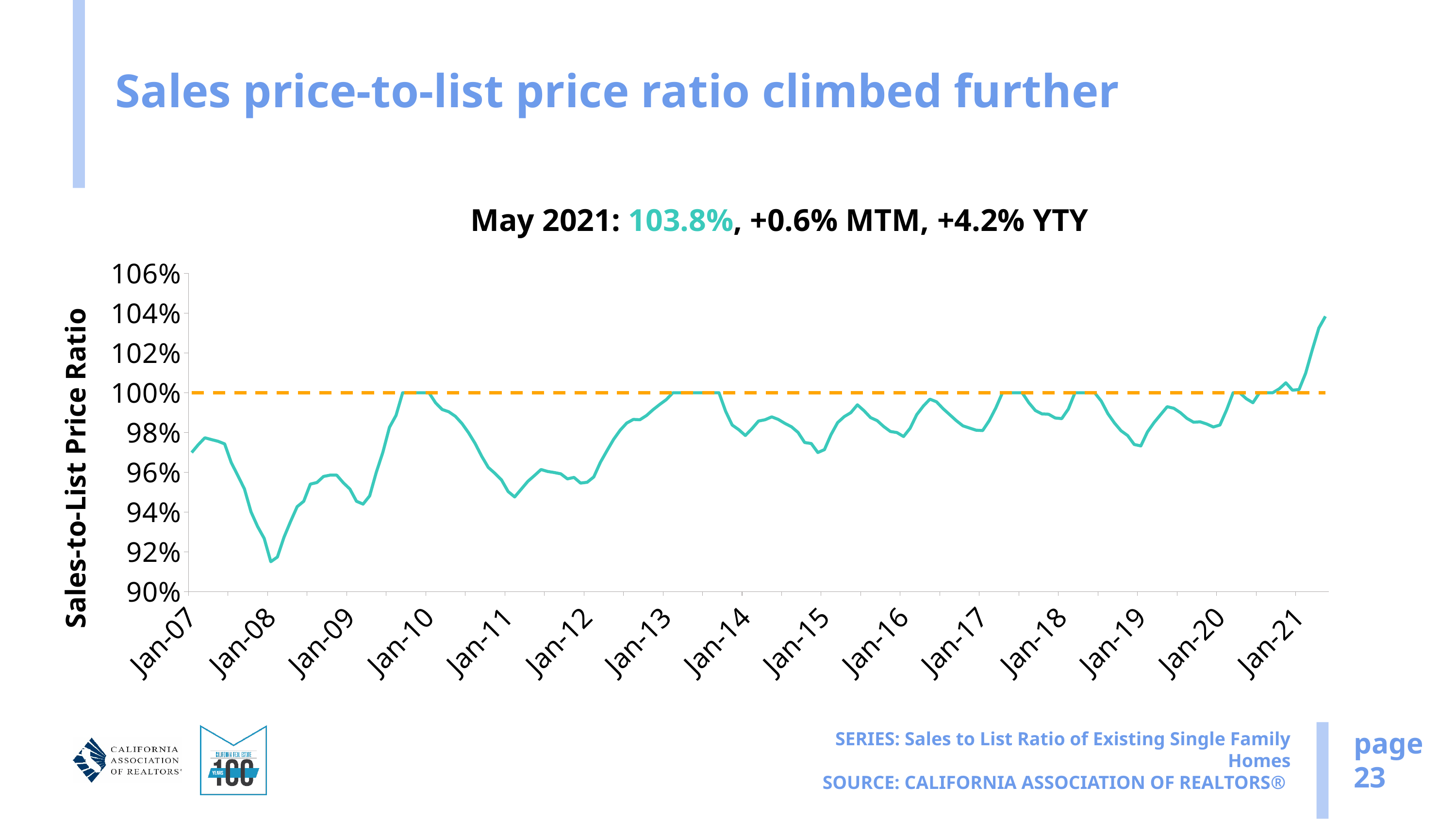
In which year does the line reach its lowest point? 2008 What is the sales-to-list price ratio for May 2021? 103.8% Is the value for Jan-11 greater or less than 98%? less Is the lowest value on the chart greater or less than 92%? less Is the value for Jan-21 greater or less than 102%? less How many year labels are shown on the x axis? 15 What kind of chart is shown on the slide? line chart At what level is the orange dashed horizontal line drawn? 100% Does the line rise or fall between Jan-20 and May 2021? rise Which is larger, the value for Jan-10 or the value for Jan-11? Jan-10 Which month has the highest sales-to-list price ratio on the chart? May 2021 What is the title of the y axis? Sales-to-List Price Ratio